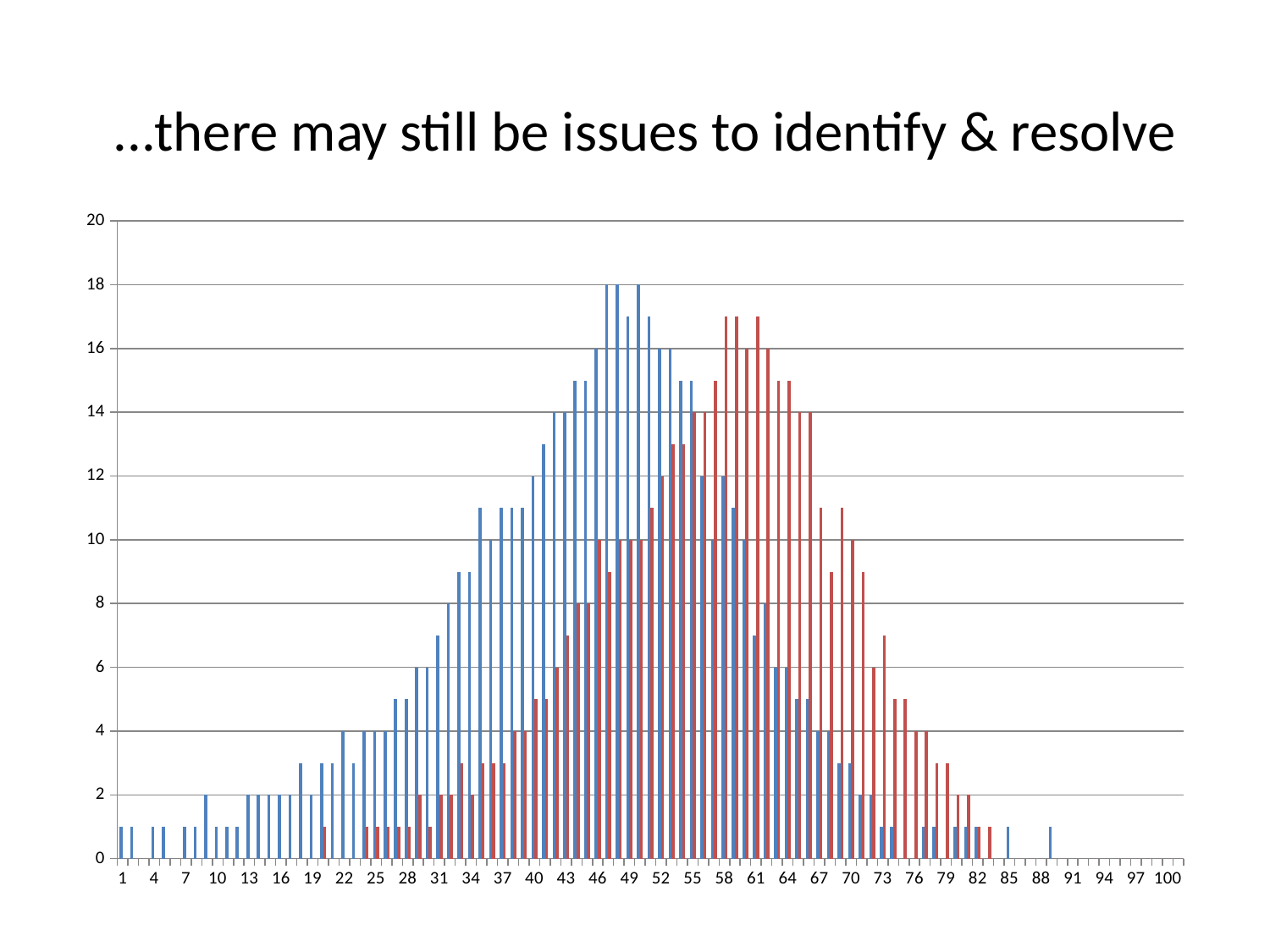
Is the blue bar at category 1 greater or less than 2? less What kind of chart is shown on the slide? bar chart Which series is centred further to the right along the x axis, the blue bars or the red bars? red Which series reaches a higher peak, the blue bars or the red bars? blue What is the highest value shown on the y axis? 20 Is the tallest blue bar greater or less than 16? greater How many differently coloured bar series are plotted in the chart? 2 Is the blue bar at category 43 greater or less than 10? greater What is the title of the slide above the chart? …there may still be issues to identify & resolve What is the last category label on the x axis? 100